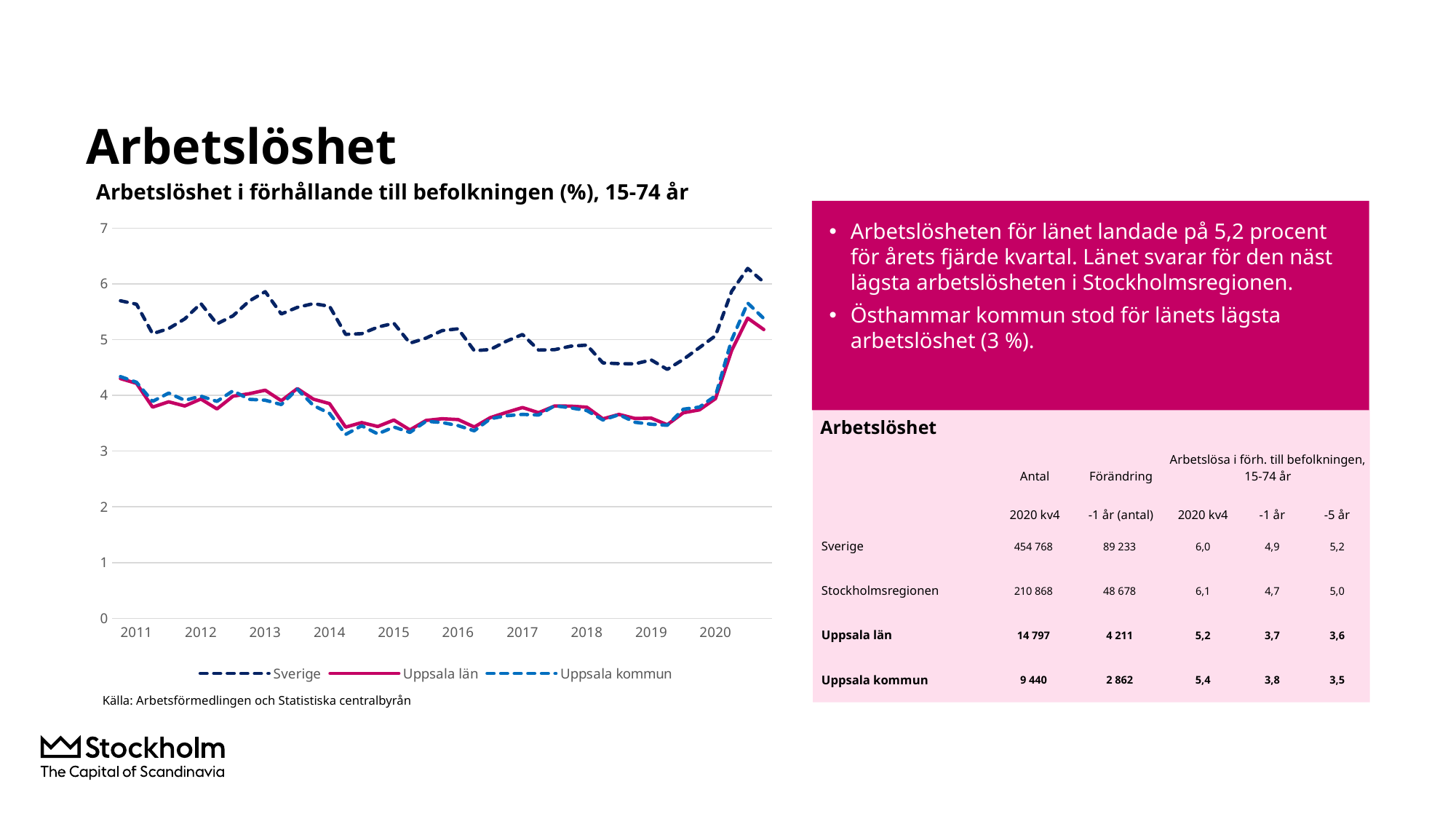
How many year labels are shown on the x axis? 10 Is the value for Uppsala kommun in 2014 greater or less than 4? less What is the title of the chart? Arbetslöshet i förhållande till befolkningen (%), 15-74 år How many series does the chart's legend list? 3 Does the Sverige line rise or fall between 2013 and 2019? fall What are the three series named in the chart's legend? Sverige, Uppsala län, Uppsala kommun Which series has the highest values across the whole period shown? Sverige Is the value for Uppsala län in 2015 greater or less than 4? less Do the values for all three series rise or fall from 2019 into 2020? rise What kind of chart is shown on the slide? line chart Is the peak value for Sverige in 2020 greater or less than 6? greater